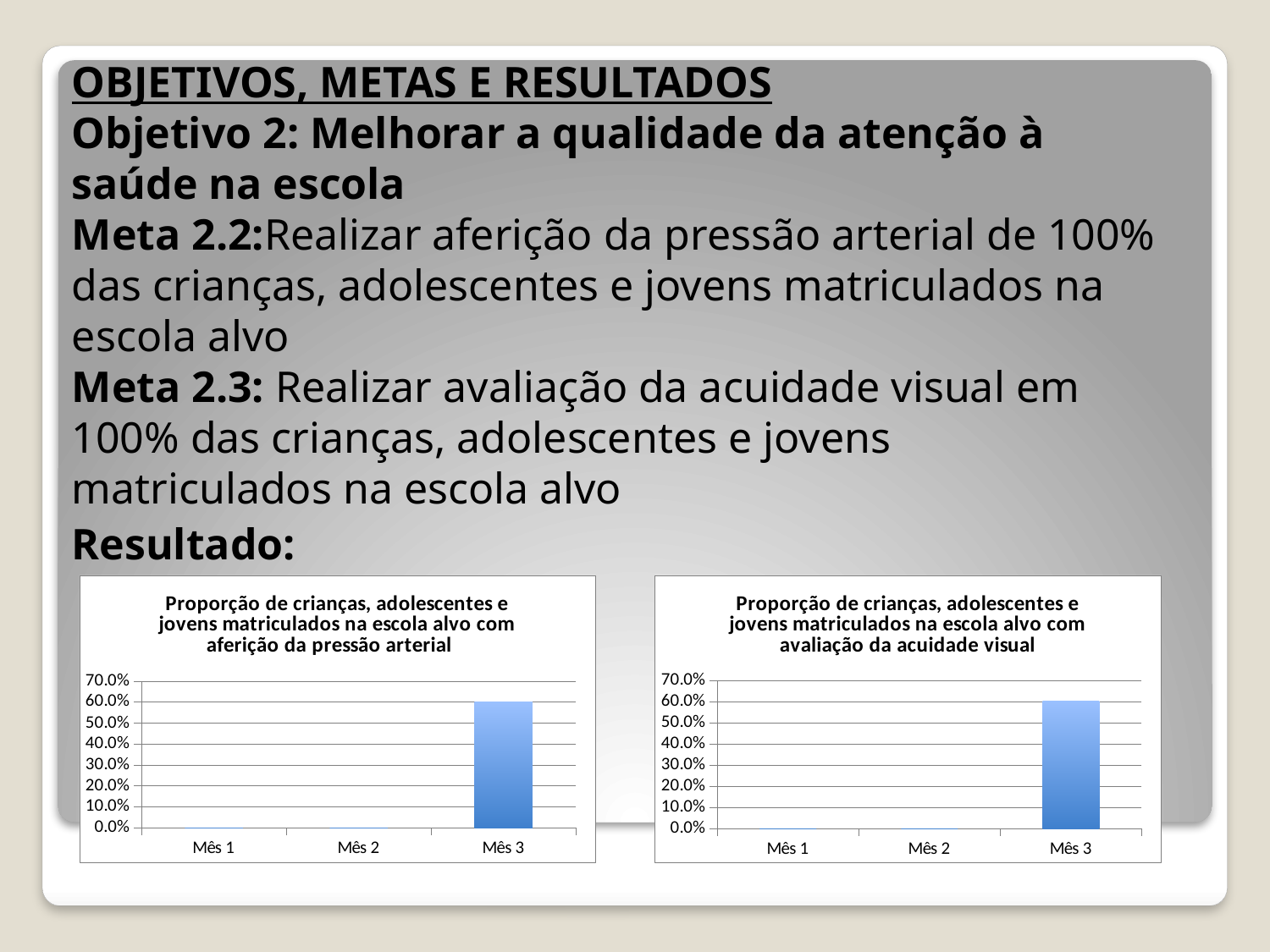
In the left chart (aferição da pressão arterial), what is the value for Mês 3? 60.0% In the right chart (avaliação da acuidade visual), what is the value for Mês 3? 60.0% In the left chart (aferição da pressão arterial), which month has the highest value? Mês 3 In the left chart (aferição da pressão arterial), is the value for Mês 3 greater or less than 50.0%? greater What type of chart is the right chart (avaliação da acuidade visual)? bar chart In the left chart (aferição da pressão arterial), is the value for Mês 1 greater or less than 10.0%? less In the left chart (aferição da pressão arterial), which is larger, the value for Mês 2 or the value for Mês 3? Mês 3 In the right chart (avaliação da acuidade visual), is the value for Mês 2 greater or less than 10.0%? less In the right chart (avaliação da acuidade visual), which month has the highest value? Mês 3 What is the highest value shown on the y axis of the right chart (avaliação da acuidade visual)? 70.0% How many months are shown on the x axis of the left chart (aferição da pressão arterial)? 3